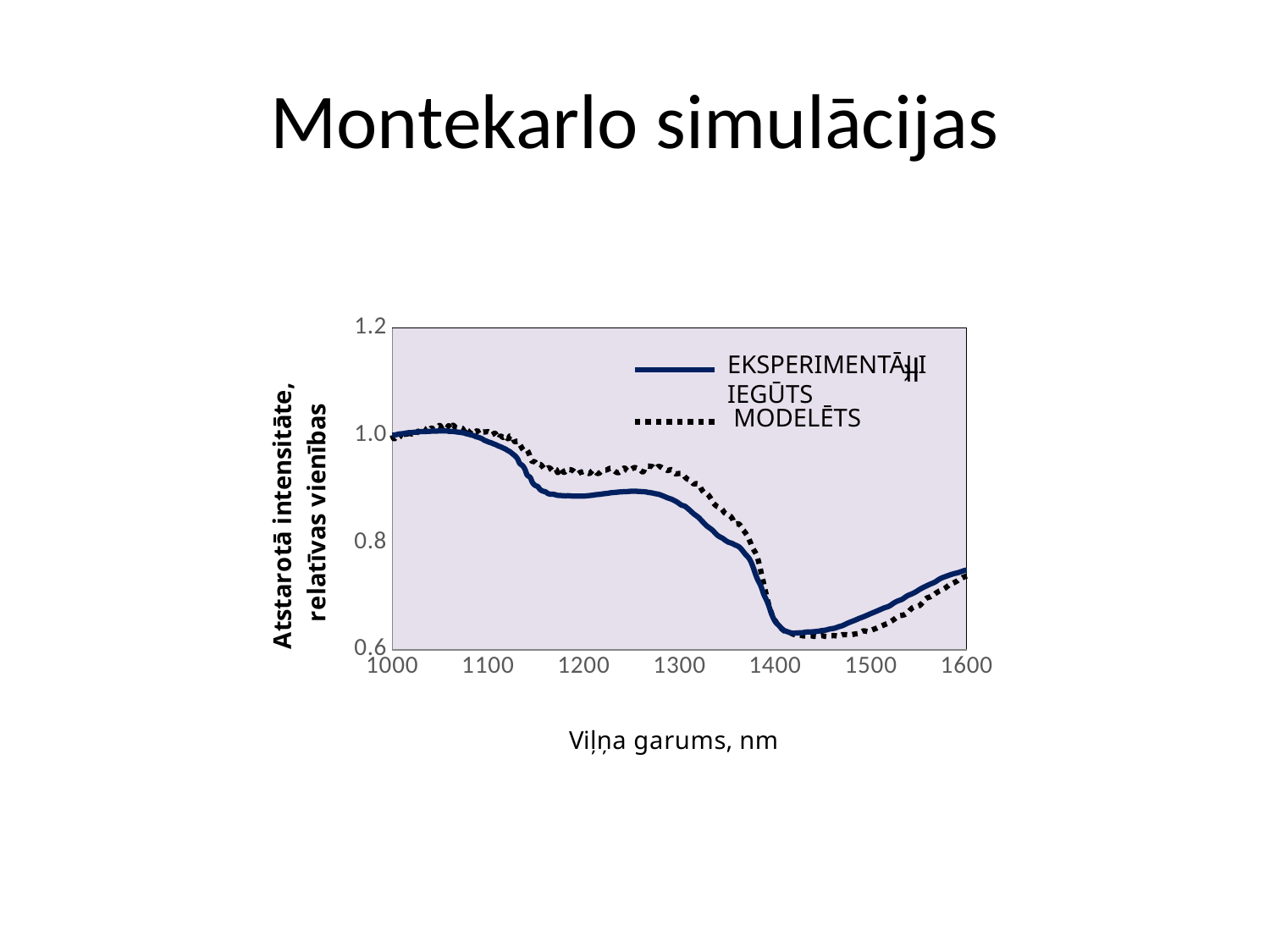
Between 1000 nm and 1400 nm, do the values of the EKSPERIMENTĀLI IEGŪTS series generally rise or fall? fall What is the label of the x axis of the chart? Viļņa garums, nm What kind of chart is shown on the slide? line chart What is the title of the slide containing the chart? Montekarlo simulācijas Is the value of the EKSPERIMENTĀLI IEGŪTS series at 1400 nm greater or less than 0.8? less At 1350 nm, which series has the higher value, EKSPERIMENTĀLI IEGŪTS or MODELĒTS? MODELĒTS At 1200 nm, which series has the higher value, EKSPERIMENTĀLI IEGŪTS or MODELĒTS? MODELĒTS Is the value of the EKSPERIMENTĀLI IEGŪTS series at 1200 nm greater or less than 1.0? less How many series does the chart legend list? 2 Is the value of the MODELĒTS series at 1300 nm greater or less than 0.8? greater Between 1450 nm and 1600 nm, do the values of the MODELĒTS series rise or fall? rise